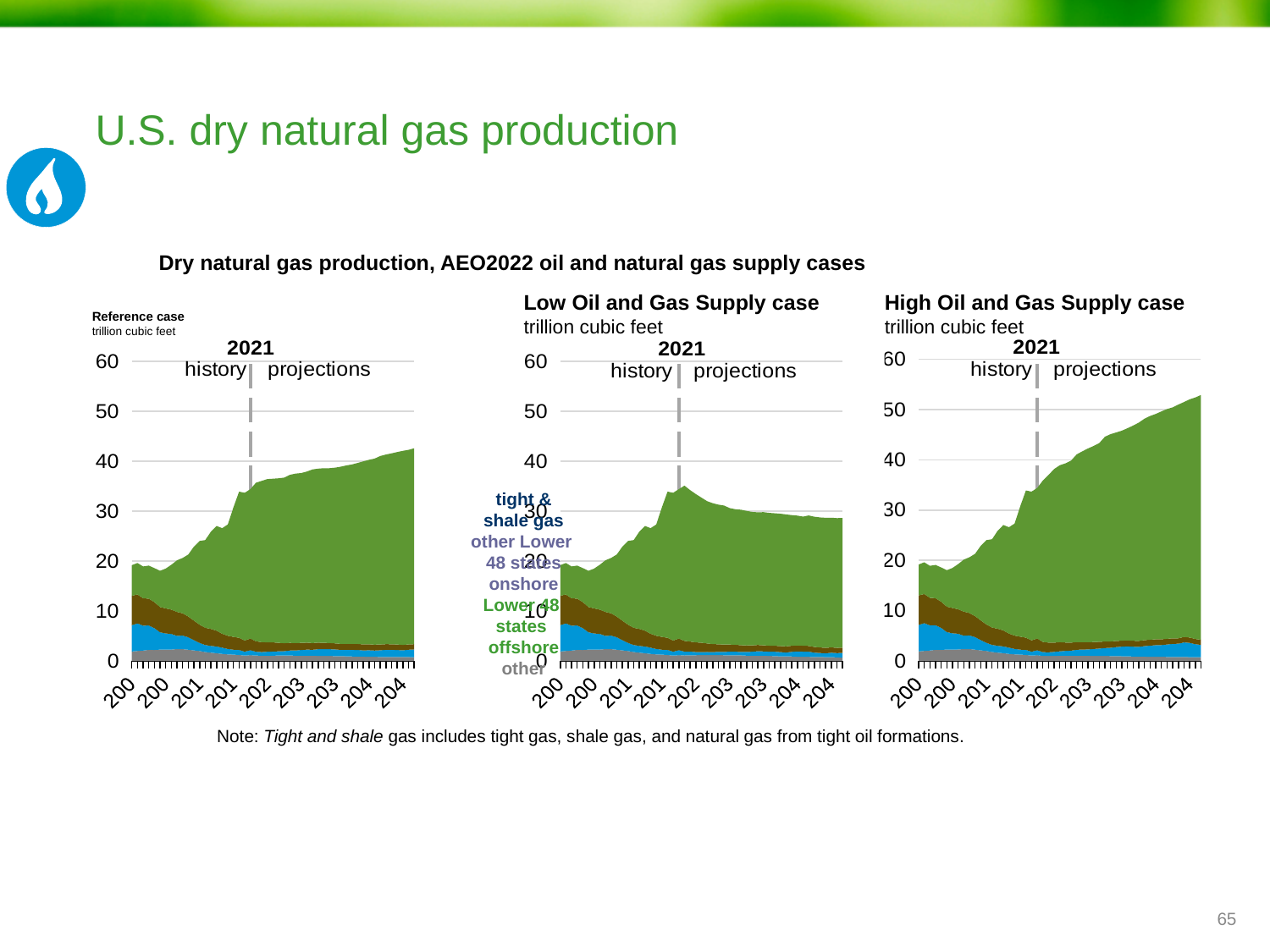
In the High Oil and Gas Supply case chart, does total production rise or fall over the projection period after 2021? rise In the Low Oil and Gas Supply case chart, is the total production at the end of the projection period greater or less than 30? less In the Low Oil and Gas Supply case chart, does total production rise or fall over the projection period after 2021? fall In the High Oil and Gas Supply case chart, is the total production at the end of the projection period greater or less than 50? greater Which chart shows the higher total production at the end of the projection period, the High Oil and Gas Supply case or the Low Oil and Gas Supply case? High Oil and Gas Supply case What year does the dashed vertical line separating history from projections mark in each chart? 2021 In the Reference case chart, is the total production in 2021 greater or less than 30? greater What unit is used on the y axis of the three charts? trillion cubic feet What kind of chart is the Reference case chart? stacked area chart How many production categories are listed in the legend of the Low Oil and Gas Supply case chart? 4 Which chart shows the higher total production at the end of the projection period, the Reference case or the Low Oil and Gas Supply case? Reference case